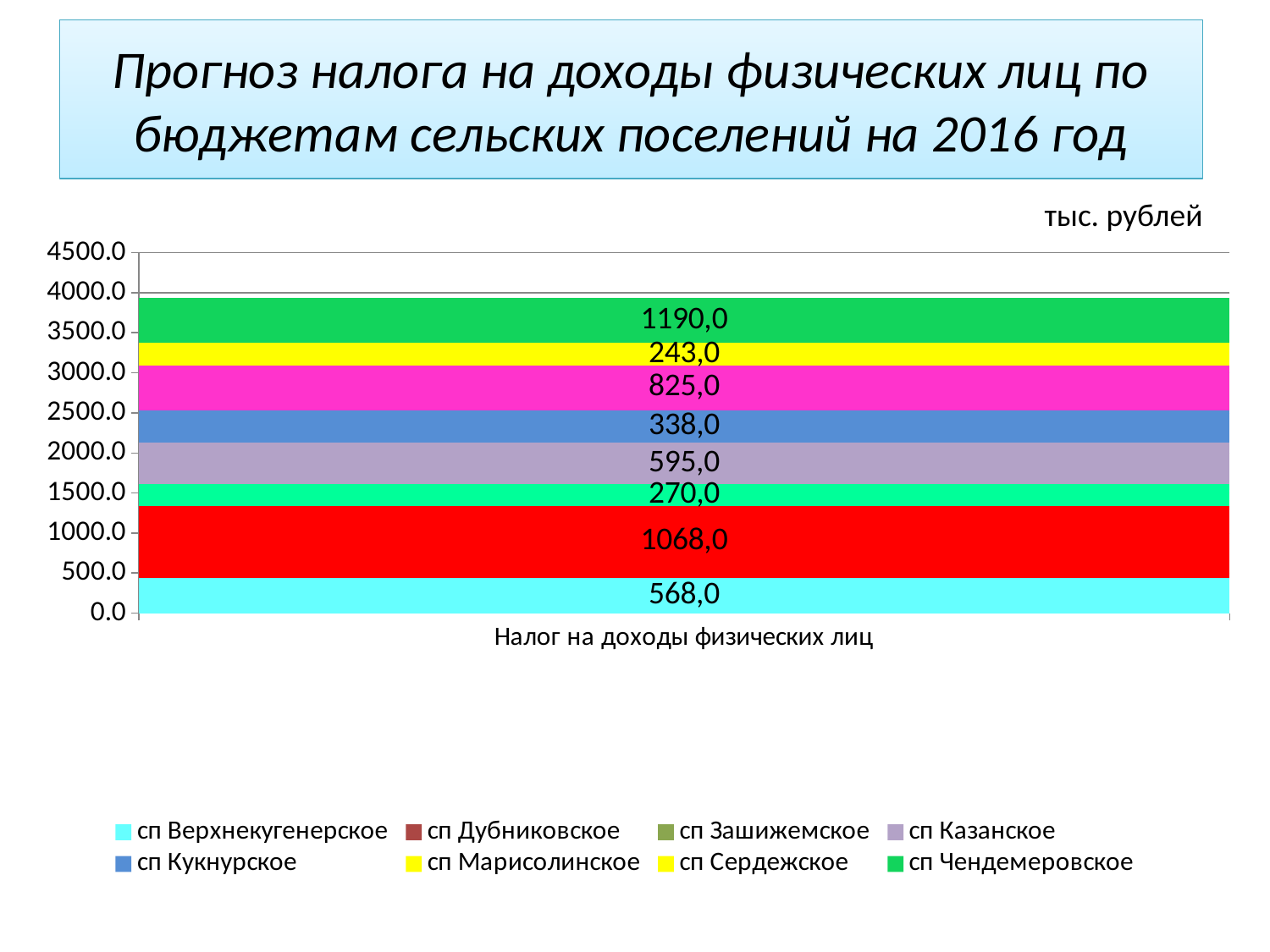
What is the smallest value labelled on the stacked bar? 243,0 What unit is stated above the chart? тыс. рублей How many series does the legend list? 8 What is the value of the green segment at the top of the stacked bar (сп Чендемеровское)? 1190,0 What is the value of the light blue segment at the bottom of the stacked bar (сп Верхнекугенерское)? 568,0 What is the value of the lavender segment (сп Казанское) in the stacked bar? 595,0 Which segment of the stacked bar has the largest value? 1190,0 (сп Чендемеровское) What is the difference between the largest segment (1190,0) and the red segment (1068,0)? 122,0 How many categories are plotted on the x axis? 1 What kind of chart is shown on the slide? stacked bar chart Which is larger: the magenta segment (825,0) or the lavender segment (595,0)? 825,0 (magenta) What is the value of the blue segment (сп Кукнурское) in the stacked bar? 338,0